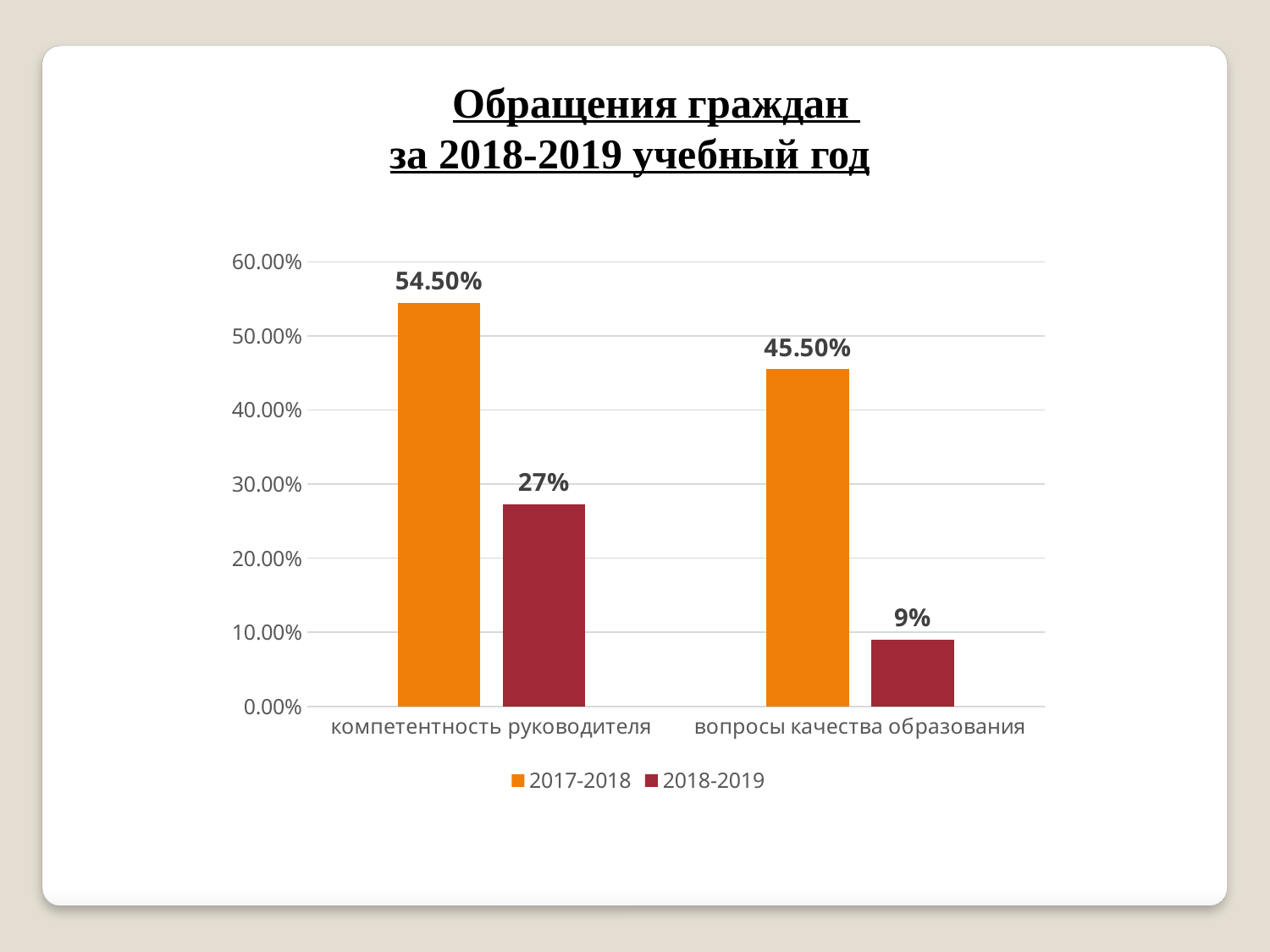
What is the value for 2017-2018 in the category компетентность руководителя? 54.50% How many series does the legend list? 2 Which category has the highest value for the 2017-2018 series? компетентность руководителя How many categories are shown on the x axis? 2 What is the value for 2018-2019 in the category вопросы качества образования? 9% What is the value for 2018-2019 in the category компетентность руководителя? 27% What kind of chart is shown on the slide? bar chart What is the difference between the 2017-2018 and 2018-2019 values for компетентность руководителя? 27.50% What is the title of the chart? Обращения граждан за 2018-2019 учебный год Which is larger: the 2018-2019 value for компетентность руководителя or the 2018-2019 value for вопросы качества образования? компетентность руководителя What is the value for 2017-2018 in the category вопросы качества образования? 45.50% Which category has the lowest value for the 2018-2019 series? вопросы качества образования